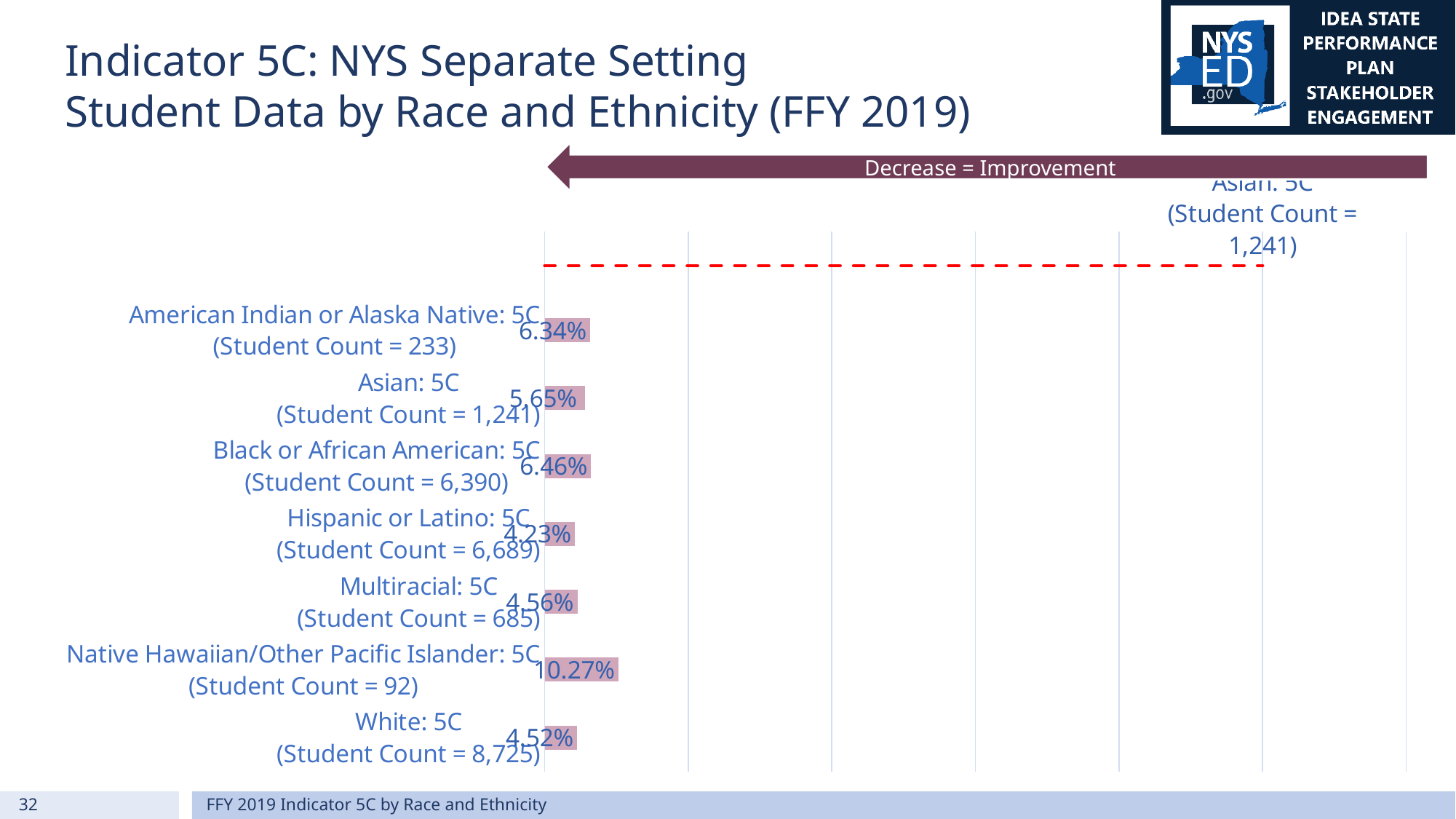
What is the value for Native Hawaiian/Other Pacific Islander: 5C? 10.27% What is the difference between the values for American Indian or Alaska Native: 5C and Asian: 5C? 0.69% What is the student count shown for the White: 5C category? 8,725 What is the value for Hispanic or Latino: 5C? 4.23% What is the value for White: 5C? 4.52% What kind of chart is shown on the slide? Bar chart Which is larger, the value for Multiracial: 5C or the value for Asian: 5C? Asian: 5C What is the difference between the values for Native Hawaiian/Other Pacific Islander: 5C and Hispanic or Latino: 5C? 6.04% What is the value for Black or African American: 5C? 6.46% Which category has the lowest value? Hispanic or Latino: 5C Which category has the highest value? Native Hawaiian/Other Pacific Islander: 5C How many race/ethnicity categories are plotted in the chart? 7